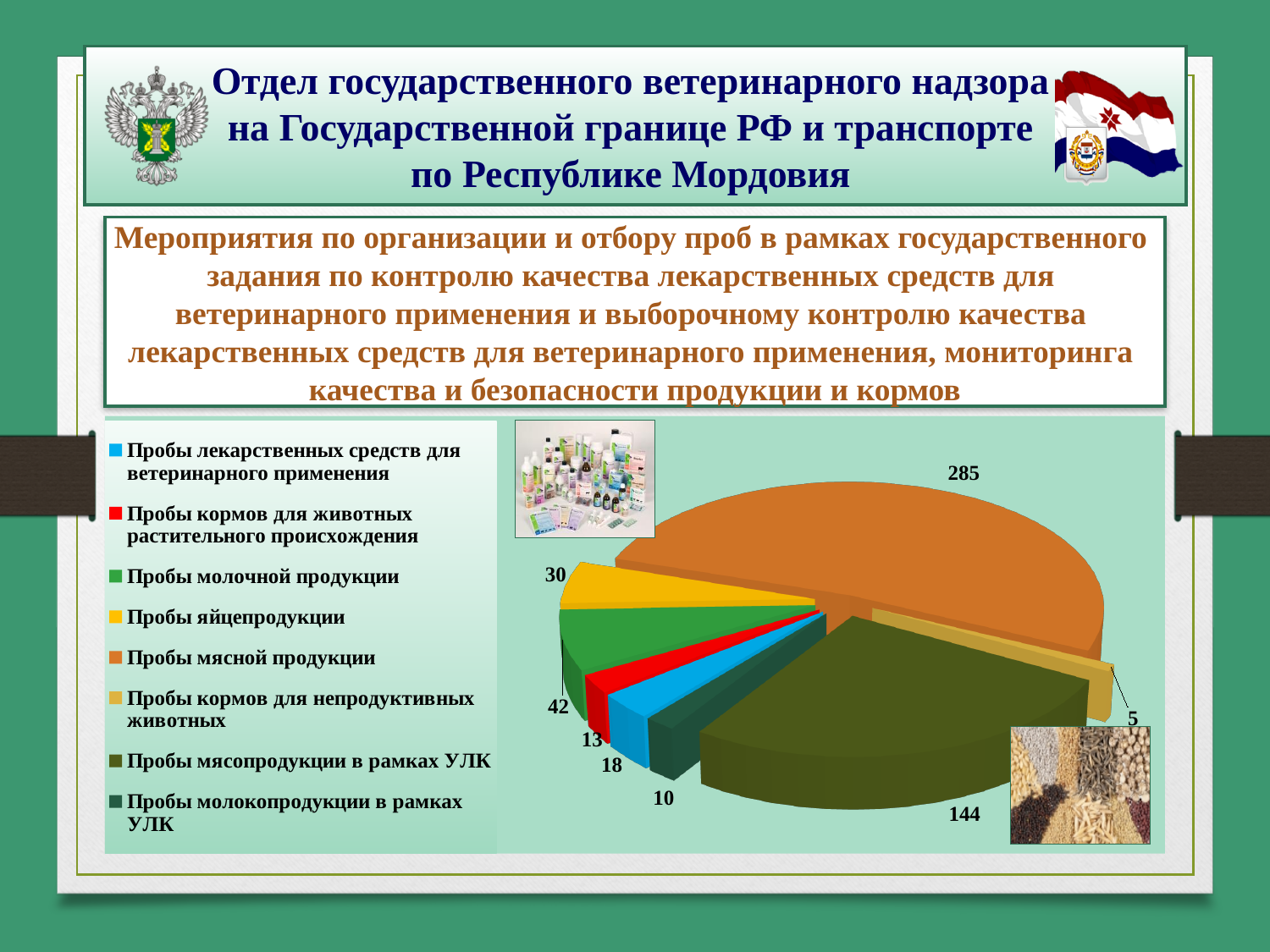
Which category has the lowest value? Пробы кормов для непродуктивных животных Which is larger: Пробы молочной продукции or Пробы яйцепродукции? Пробы молочной продукции What is the value for Пробы мясопродукции в рамках УЛК? 144 What is the difference between the values for Пробы мясной продукции and Пробы мясопродукции в рамках УЛК? 141 Which category has the highest value? Пробы мясной продукции What is the value for Пробы яйцепродукции? 30 What is the value for Пробы кормов для непродуктивных животных? 5 What is the value for Пробы мясной продукции? 285 How many categories does the legend list? 8 What is the value for Пробы молочной продукции? 42 What is the value for Пробы лекарственных средств для ветеринарного применения? 18 What kind of chart is shown on the slide? Pie chart